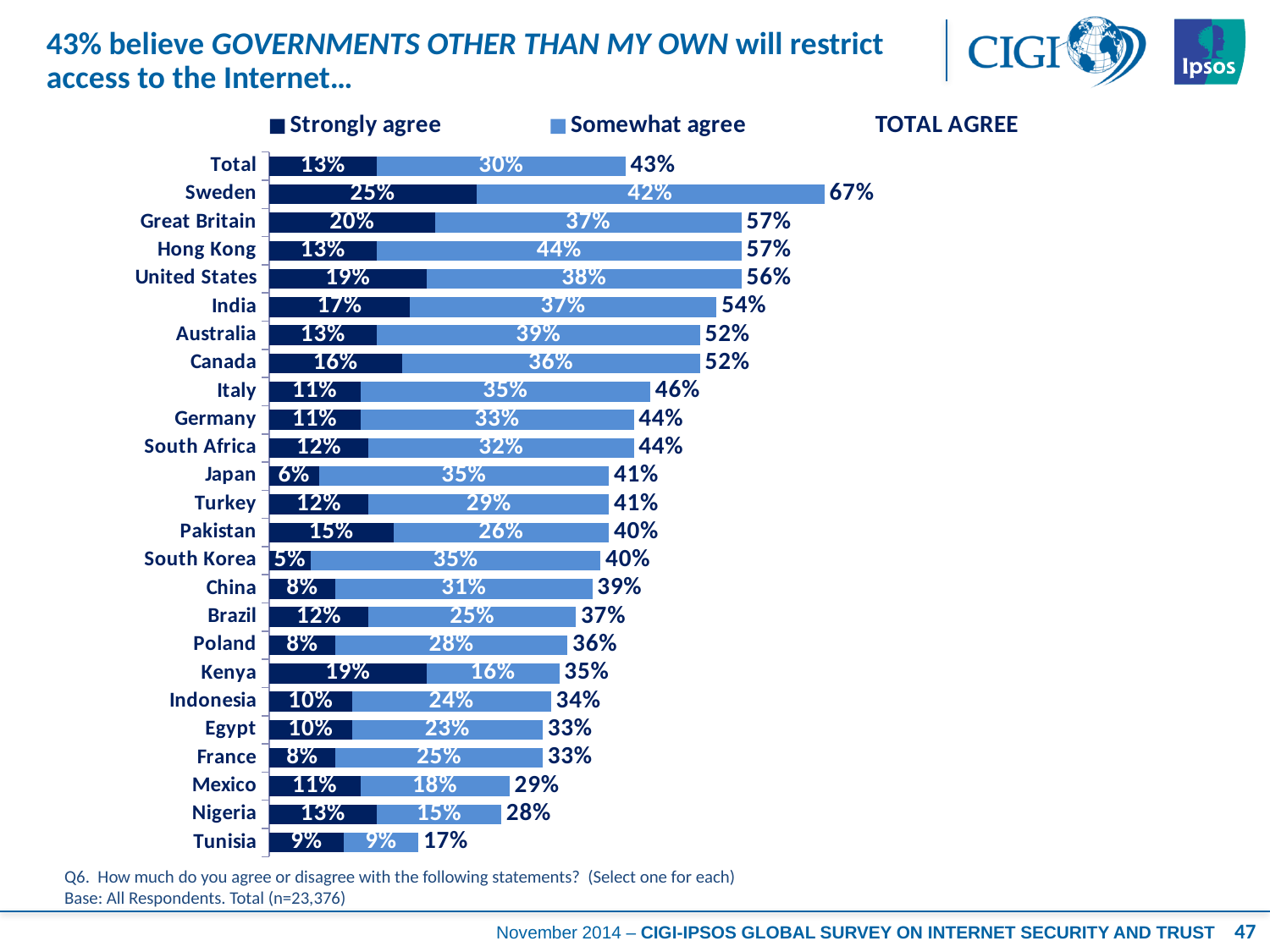
How many categories (rows) are plotted in the chart? 25 How many series does the legend list? 2 Which country has the lowest total agree value? Tunisia What is the Somewhat agree value for Hong Kong? 44% What percentage of respondents in Sweden strongly agree? 25% Which has a larger Strongly agree value, Kenya or Nigeria? Kenya What are the two legend entries in the chart? Strongly agree, Somewhat agree What is the difference between the total agree values for Sweden and Tunisia? 50% Which country has the highest total agree value? Sweden What kind of chart is shown on the slide? Stacked bar chart What is the total of the stacked bar for Pakistan? 40% What is the total agree value for Japan? 41%